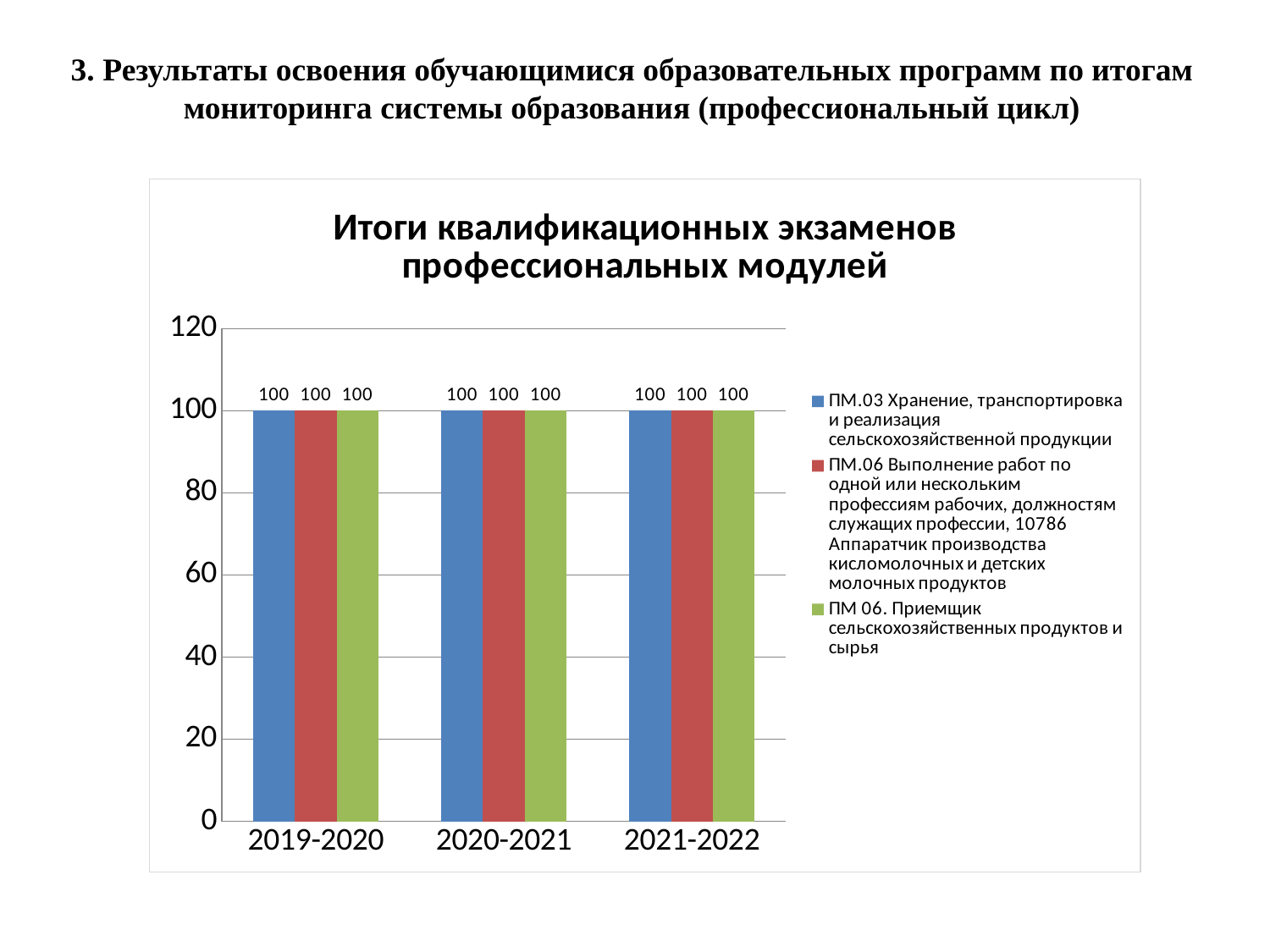
What is the title of the chart? Итоги квалификационных экзаменов профессиональных модулей How many year categories are shown on the x axis? 3 What is the value for ПМ.03 Хранение, транспортировка и реализация сельскохозяйственной продукции in 2019-2020? 100 Do the values for ПМ.03 rise, fall, or stay the same from 2019-2020 to 2021-2022? stay the same What is the difference between the ПМ.03 value in 2019-2020 and the ПМ.03 value in 2021-2022? 0 Is the value for ПМ.03 in 2021-2022 greater or less than 120? less What is the value for ПМ 06. Приемщик сельскохозяйственных продуктов и сырья in 2021-2022? 100 Is the value for ПМ 06. Приемщик сельскохозяйственных продуктов и сырья in 2020-2021 greater or less than 80? greater What colour represents the ПМ 06. Приемщик сельскохозяйственных продуктов и сырья series? green What kind of chart is shown on the slide? bar chart How many series does the legend list? 3 What is the value for the ПМ.06 Выполнение работ по одной или нескольким профессиям рабочих series in 2020-2021? 100